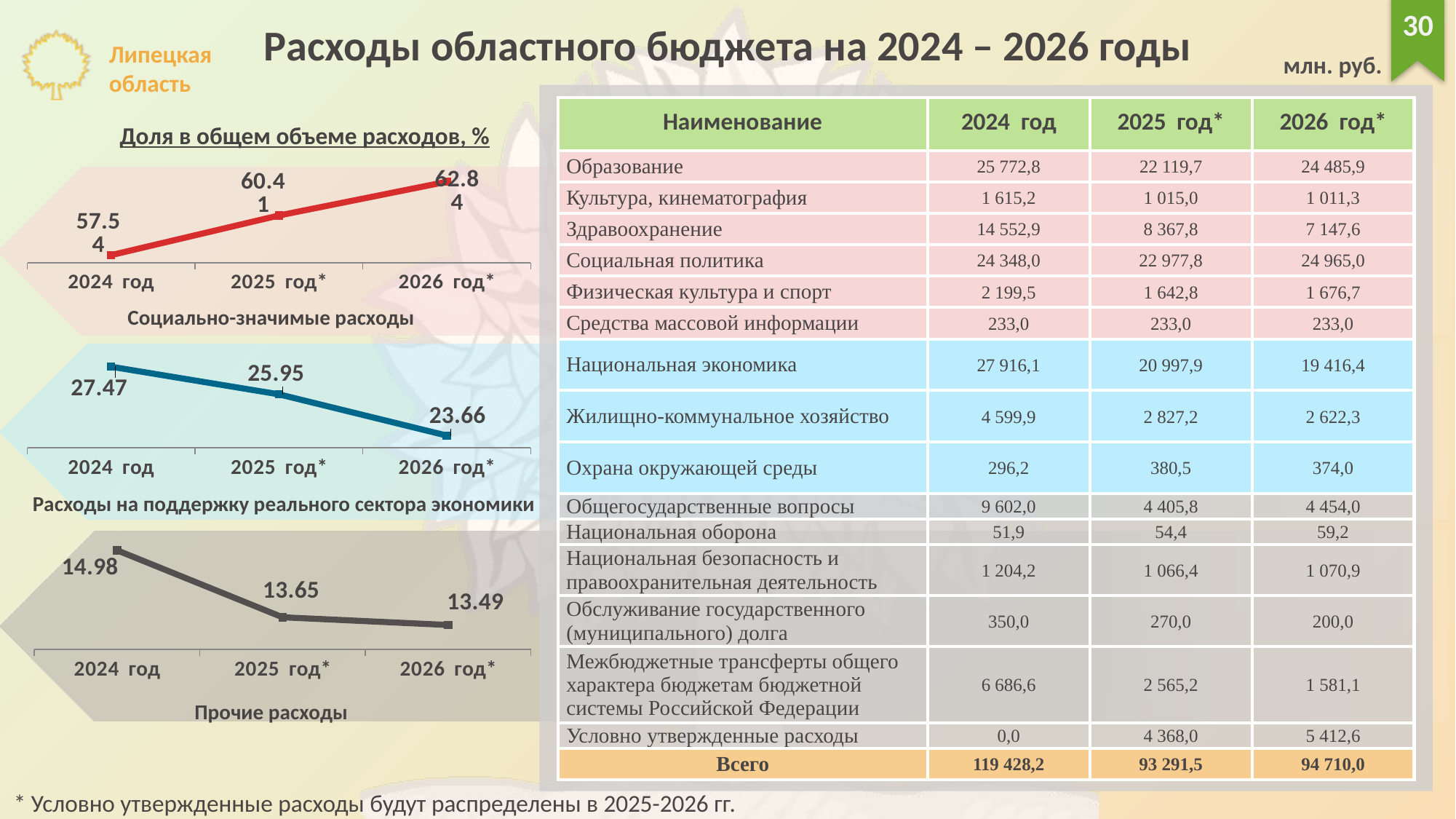
In the chart titled 'Прочие расходы', what is the value for 2024 год? 14.98 In the chart titled 'Расходы на поддержку реального сектора экономики', what is the value for 2026 год*? 23.66 In the chart titled 'Прочие расходы', which year has the lowest value? 2026 год* What kind of chart is the chart titled 'Социально-значимые расходы'? line chart How many data points are plotted in the chart titled 'Прочие расходы'? 3 In the chart titled 'Расходы на поддержку реального сектора экономики', do the values rise or fall from 2024 год to 2026 год*? fall In the chart titled 'Прочие расходы', what is the difference between the 2024 год value and the 2025 год* value? 1.33 In the chart titled 'Прочие расходы', what is the value for 2025 год*? 13.65 In the chart titled 'Расходы на поддержку реального сектора экономики', what is the difference between the 2024 год value and the 2026 год* value? 3.81 In the chart titled 'Расходы на поддержку реального сектора экономики', what is the value for 2024 год? 27.47 In the chart titled 'Расходы на поддержку реального сектора экономики', which year has the highest value? 2024 год In the chart titled 'Социально-значимые расходы', do the values rise or fall from 2024 год to 2026 год*? rise